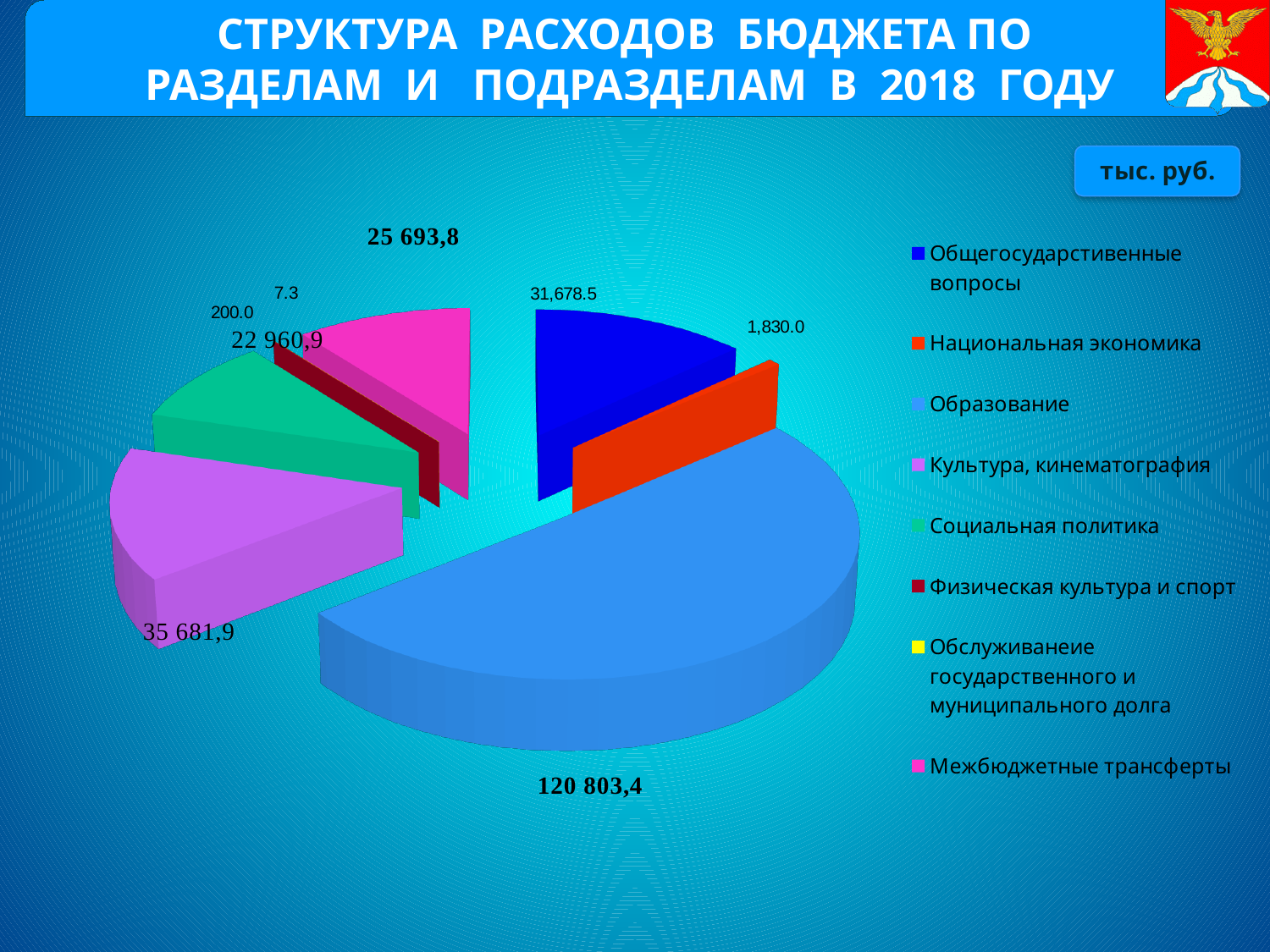
Which category has the largest slice of the pie chart? Образование In what units are the values on the chart given, according to the label on the slide? тыс. руб. What is the difference between the value for Культура, кинематография (35 681,9) and the value for Общегосударственные вопросы (31,678.5)? 4 003,4 What is the value shown for Национальная экономика? 1,830.0 How many categories does the legend of the pie chart list? 8 What is the value shown for Межбюджетные трансферты? 25 693,8 What is the value shown for Социальная политика? 22 960,9 What is the value shown for Культура, кинематография? 35 681,9 Which is larger: the value for Культура, кинематография or the value for Общегосударственные вопросы? Культура, кинематография What is the value shown for Общегосударственные вопросы? 31,678.5 What is the value shown for the largest slice (Образование)? 120 803,4 What kind of chart is shown on the slide? pie chart